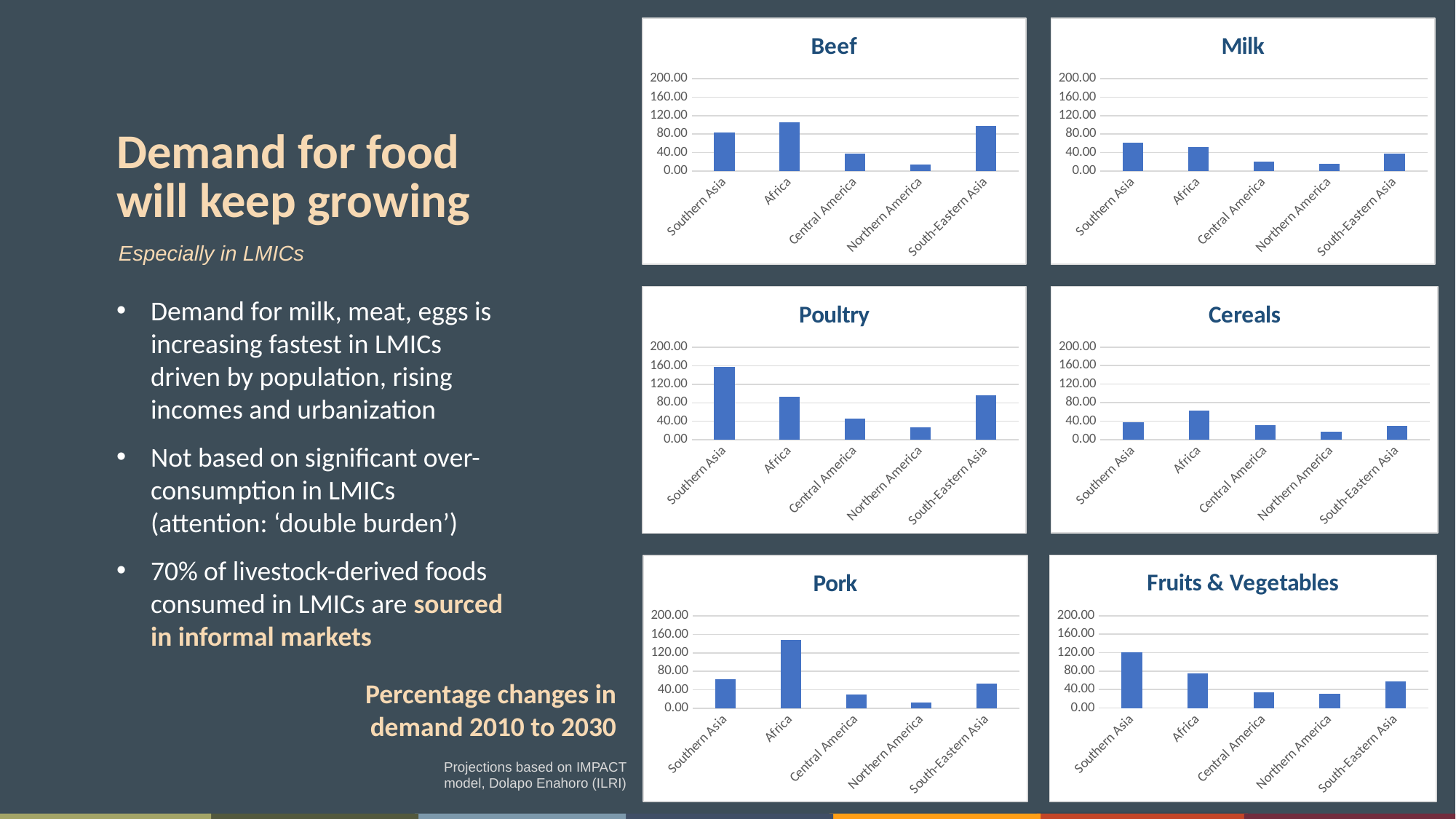
In the Beef chart, which region has the lowest value? Northern America In the Fruits & Vegetables chart, which is larger, the value for Africa or the value for South-Eastern Asia? Africa How many regions are shown on the x axis of the Cereals chart? 5 In the Beef chart, is the value for Northern America greater or less than 40? less In the Milk chart, which is larger, the value for Southern Asia or the value for Central America? Southern Asia In the Pork chart, is the value for Africa greater or less than 120? greater What kind of chart is the Beef chart? Bar chart In the Pork chart, which region has the highest value? Africa In the Cereals chart, which region has the highest value? Africa In the Fruits & Vegetables chart, which region has the highest value? Southern Asia In the Poultry chart, is the value for Southern Asia greater or less than 120? greater